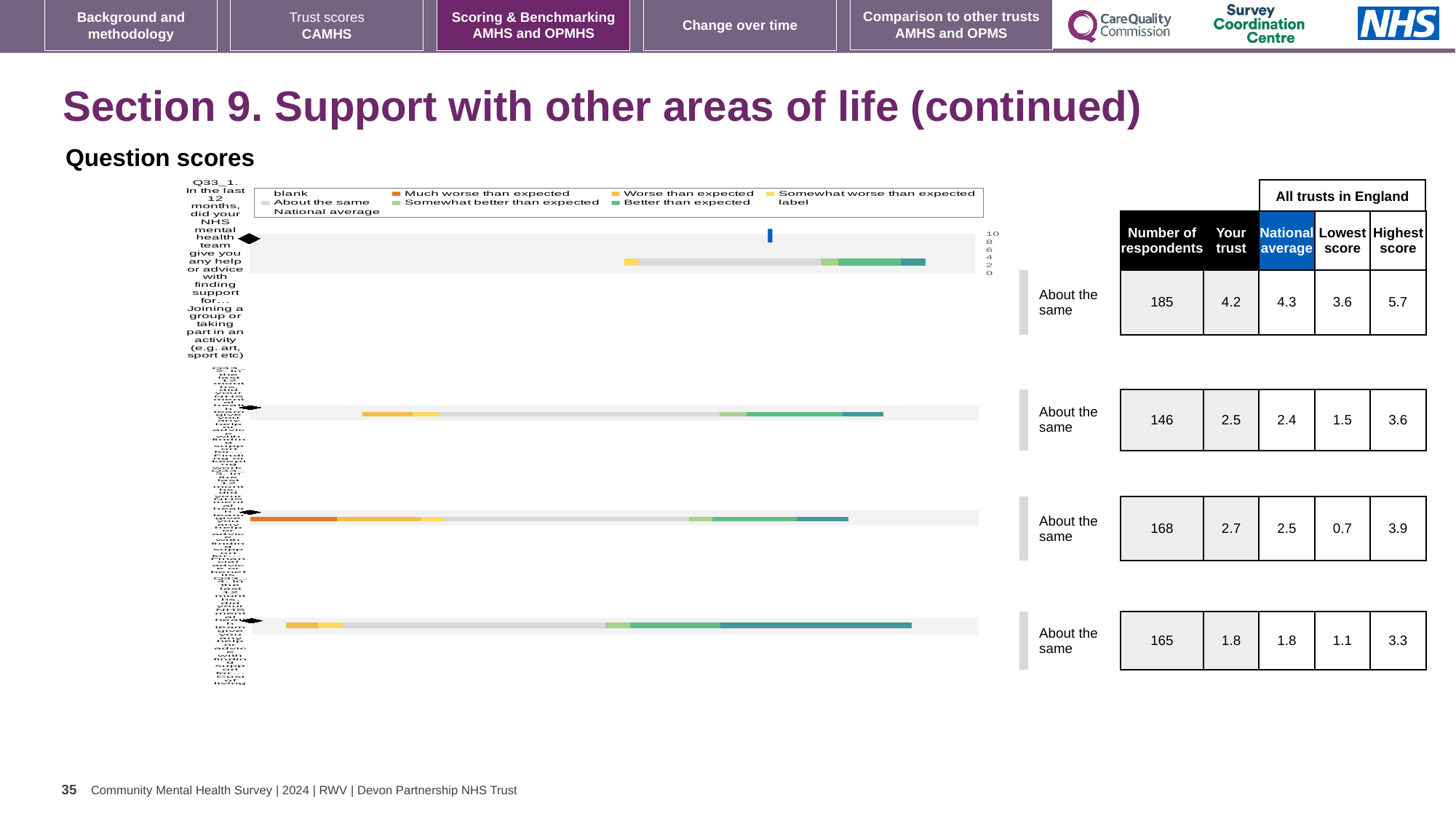
What kind of chart is shown under 'Question scores'? bar chart Which of the four question rows has the highest 'Your trust' score? Q33_1 (joining a group or taking part in an activity) How many entries does the chart legend list? 9 What is the national average for Q33_1 (joining a group or taking part in an activity)? 4.3 What colour does the legend use for 'Much worse than expected'? orange What benchmark category is shown next to the bar for Q33_1 (joining a group or taking part in an activity)? About the same How many respondents are listed for Q33_1 (joining a group or taking part in an activity)? 185 What is the difference between the highest score and the lowest score for Q33_1 (joining a group or taking part in an activity)? 2.1 What is the 'Your trust' score for Q33_1 (joining a group or taking part in an activity)? 4.2 How many question bars are plotted in the chart? 4 Which of the four question rows has the lowest 'Your trust' score? the fourth (bottom) row For the second question row, which is larger: the 'Your trust' score or the national average? Your trust